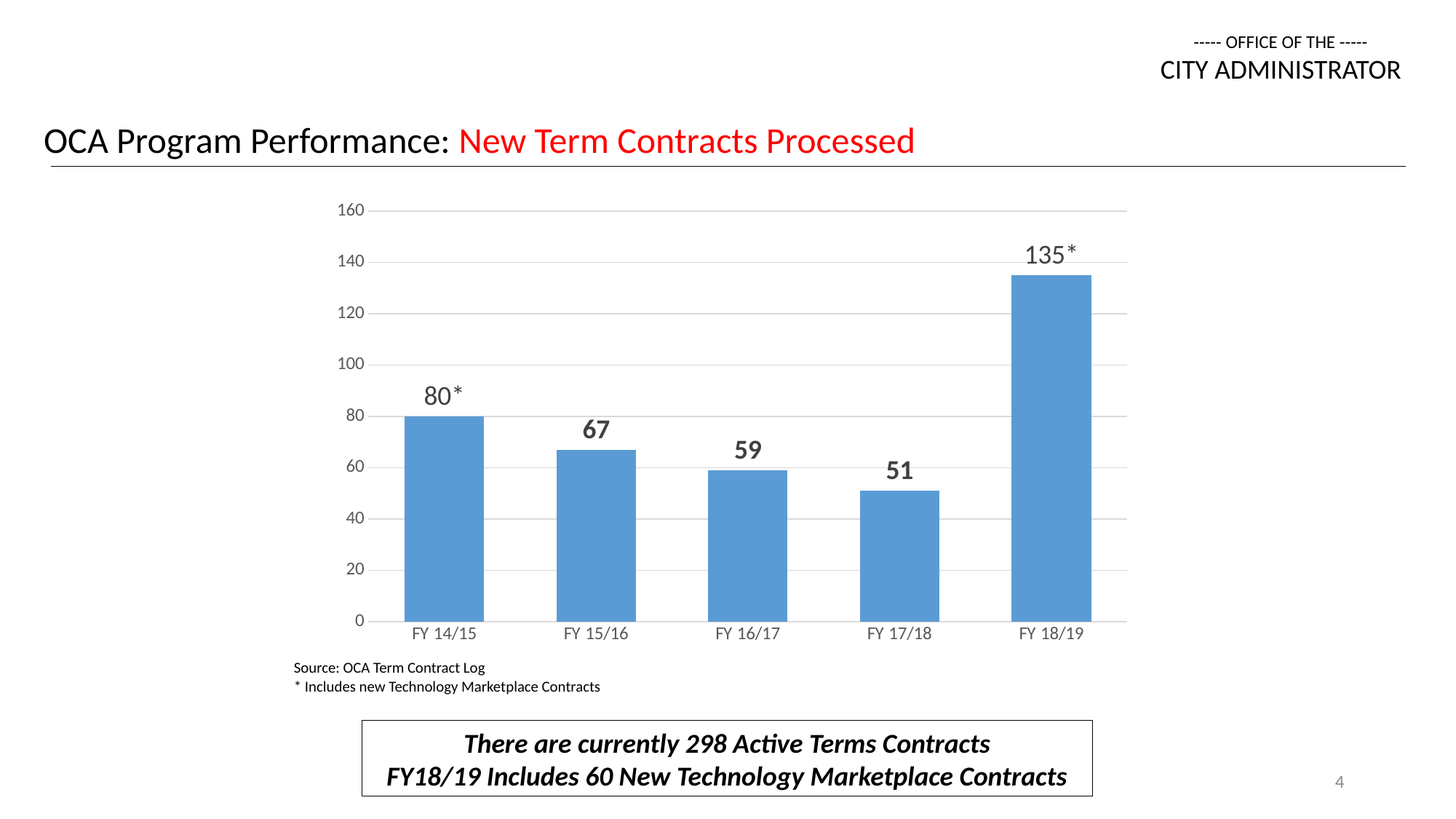
What is the value for FY 18/19? 135* Do the values rise or fall from FY 14/15 to FY 17/18? Fall Which is larger, the value for FY 14/15 or the value for FY 16/17? FY 14/15 What kind of chart is shown on the slide? Bar chart Which fiscal year has the lowest value? FY 17/18 What is the value for FY 14/15? 80* Which fiscal year has the highest value? FY 18/19 What is the value for FY 15/16? 67 What is the difference between the values for FY 15/16 and FY 16/17? 8 What is the value for FY 17/18? 51 How many fiscal years are shown on the x axis? 5 What is the difference between the values for FY 18/19 and FY 14/15? 55